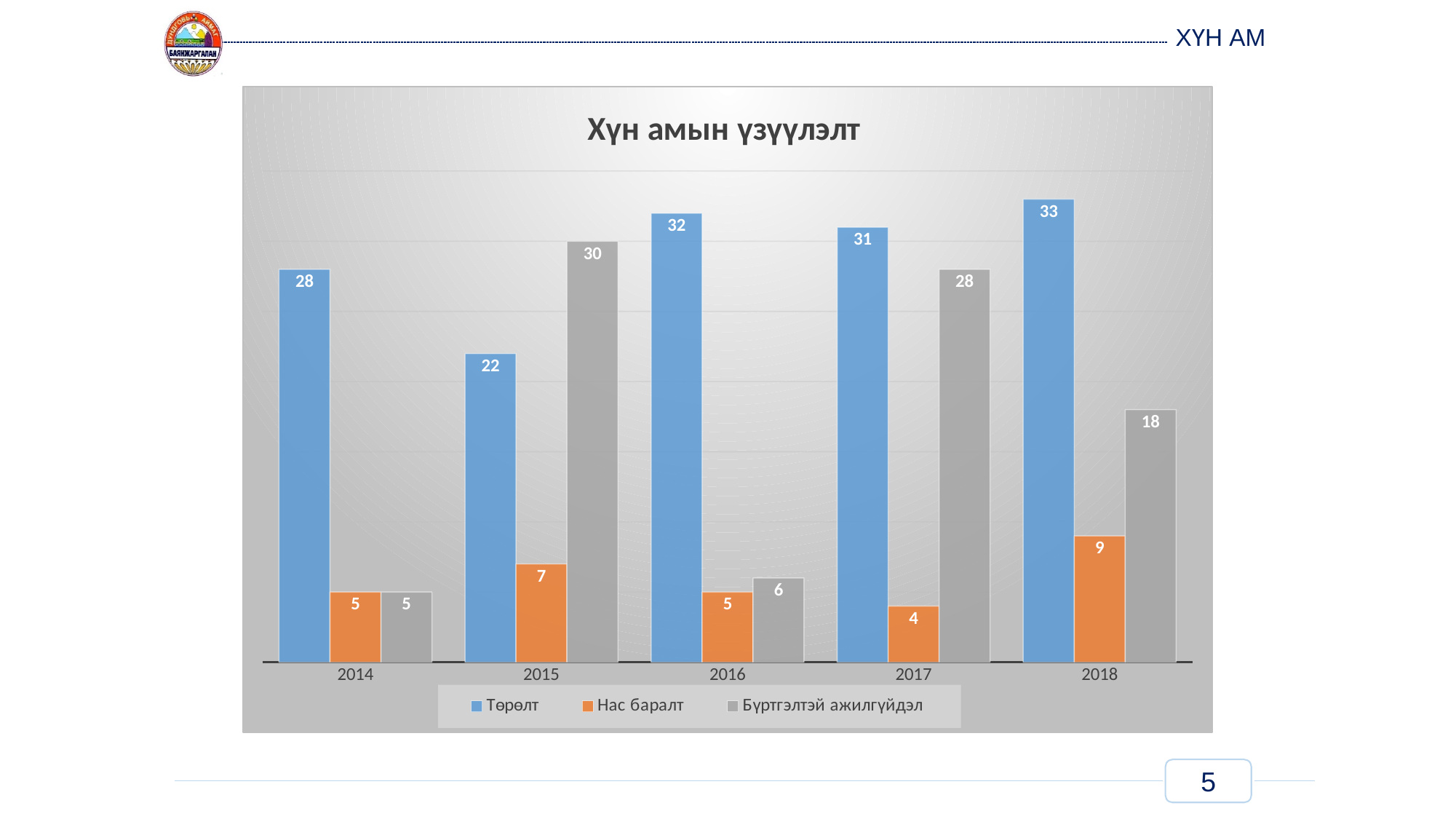
What kind of chart is shown? bar chart In which year is Төрөлт the highest? 2018 What is the difference between Төрөлт and Бүртгэлтэй ажилгүйдэл in 2018? 15 In which year is Төрөлт the lowest? 2015 What is the value of Нас баралт in 2017? 4 What is the value of Бүртгэлтэй ажилгүйдэл in 2015? 30 What is the title of the chart? Хүн амын үзүүлэлт What is the value of Төрөлт in 2018? 33 Which is larger in 2015: Төрөлт or Бүртгэлтэй ажилгүйдэл? Бүртгэлтэй ажилгүйдэл How many years are shown on the x axis? 5 How many series does the legend list? 3 In which year is Нас баралт the highest? 2018